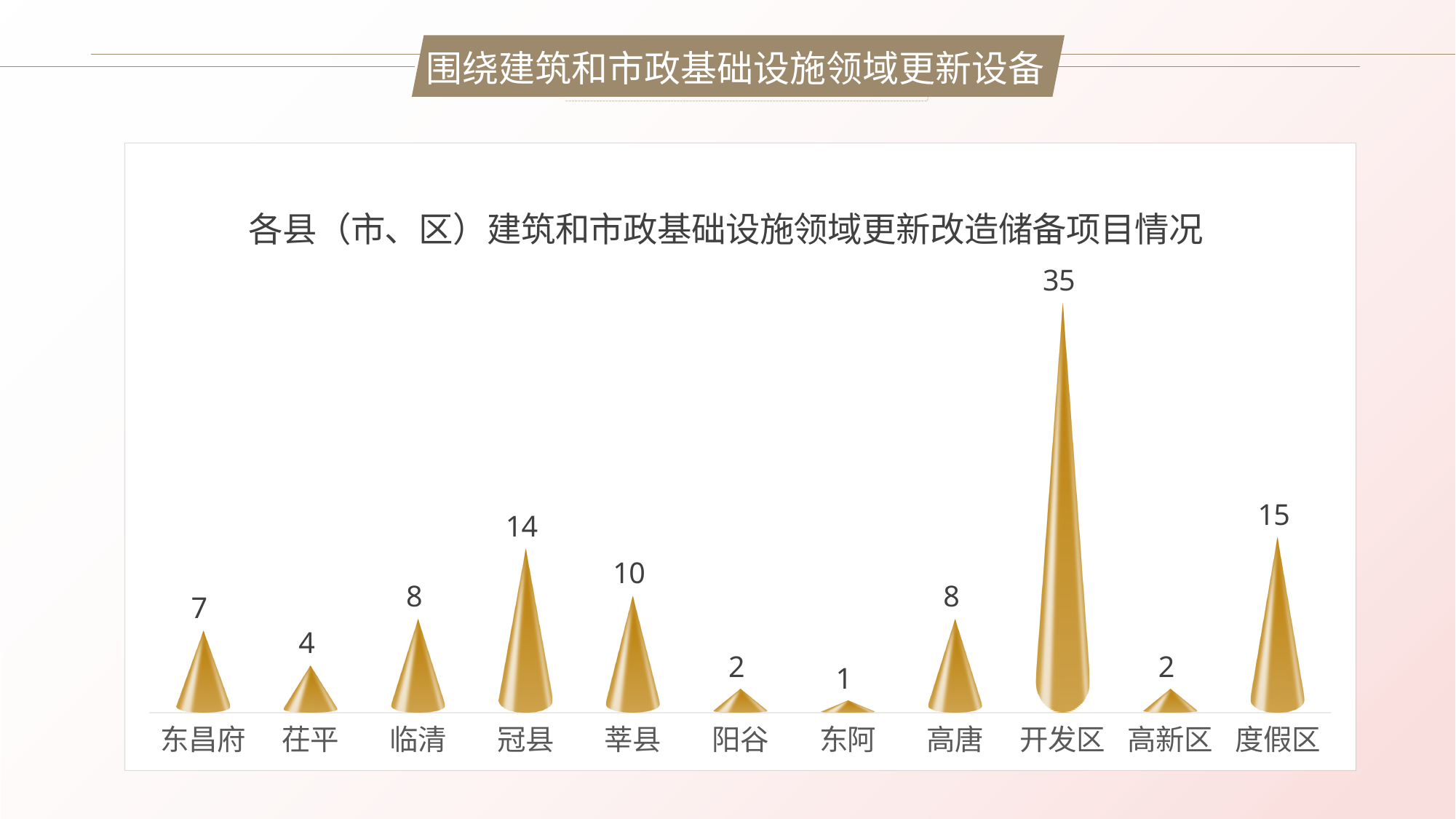
What is the difference between the values for 开发区 and 度假区? 20 What is the title of the chart? 各县（市、区）建筑和市政基础设施领域更新改造储备项目情况 What is the value for 东昌府? 7 Which category has the highest value? 开发区 Which is larger, the value for 临清 or the value for 茌平? 临清 How many categories are shown on the x axis? 11 Which two categories both have a value of 2? 阳谷 and 高新区 What is the difference between the values for 冠县 and 莘县? 4 What kind of chart is this? bar chart Which category has the lowest value? 东阿 What is the value for 开发区? 35 What is the value for 冠县? 14